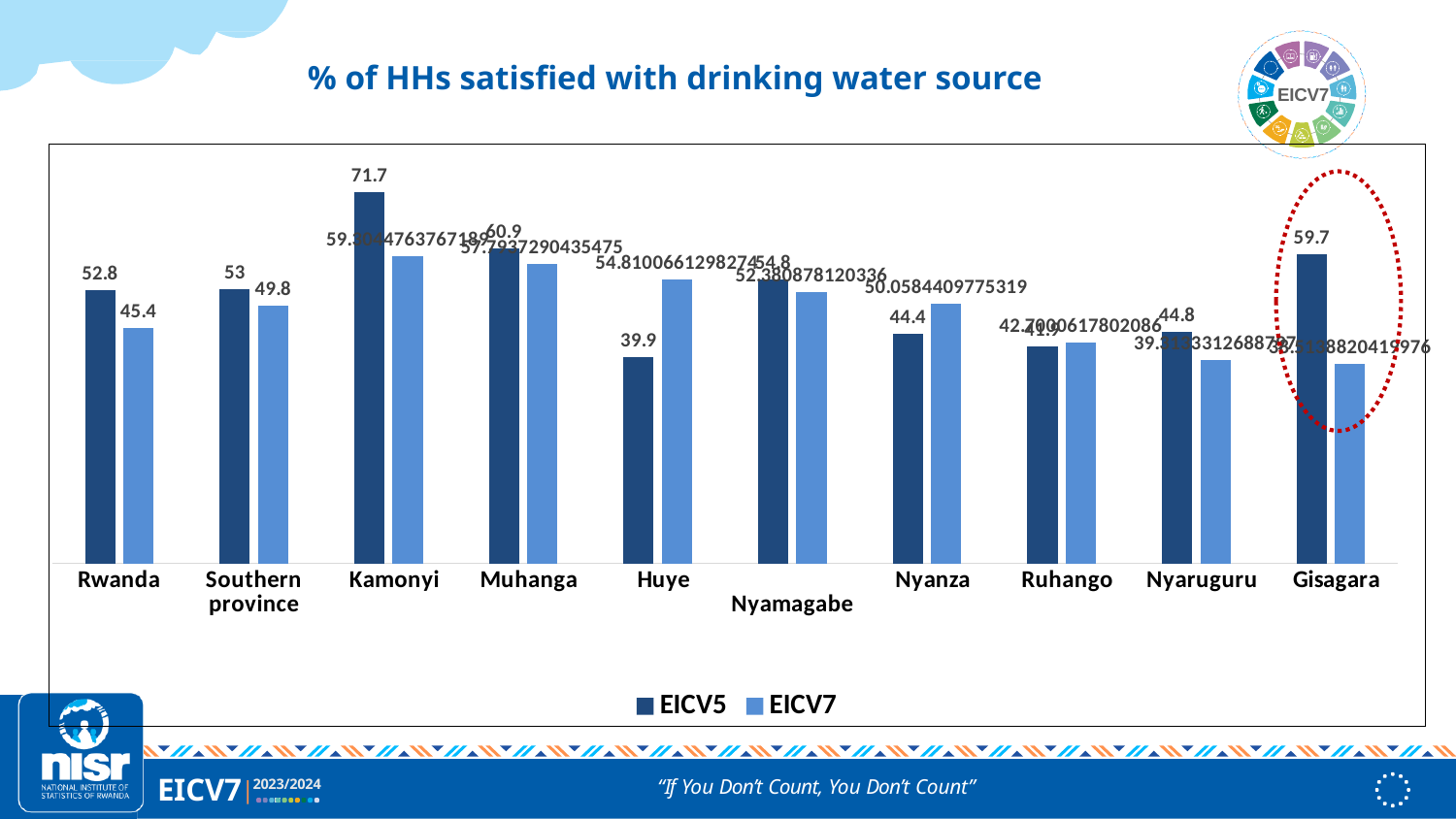
What is the EICV5 value for Huye? 39.9 What is the EICV5 value for Rwanda? 52.8 What is the difference between the EICV5 and EICV7 values for Rwanda? 7.4 What is the EICV5 value for Gisagara? 59.7 Which category has the highest EICV5 value? Kamonyi For Huye, which is larger: the EICV5 value or the EICV7 value? EICV7 How many categories are shown on the x axis? 10 What is the EICV7 value for Southern province? 49.8 What is the EICV7 value for Rwanda? 45.4 Which category has the lowest EICV5 value? Huye How many series does the legend list? 2 What kind of chart is shown on the slide? Bar chart